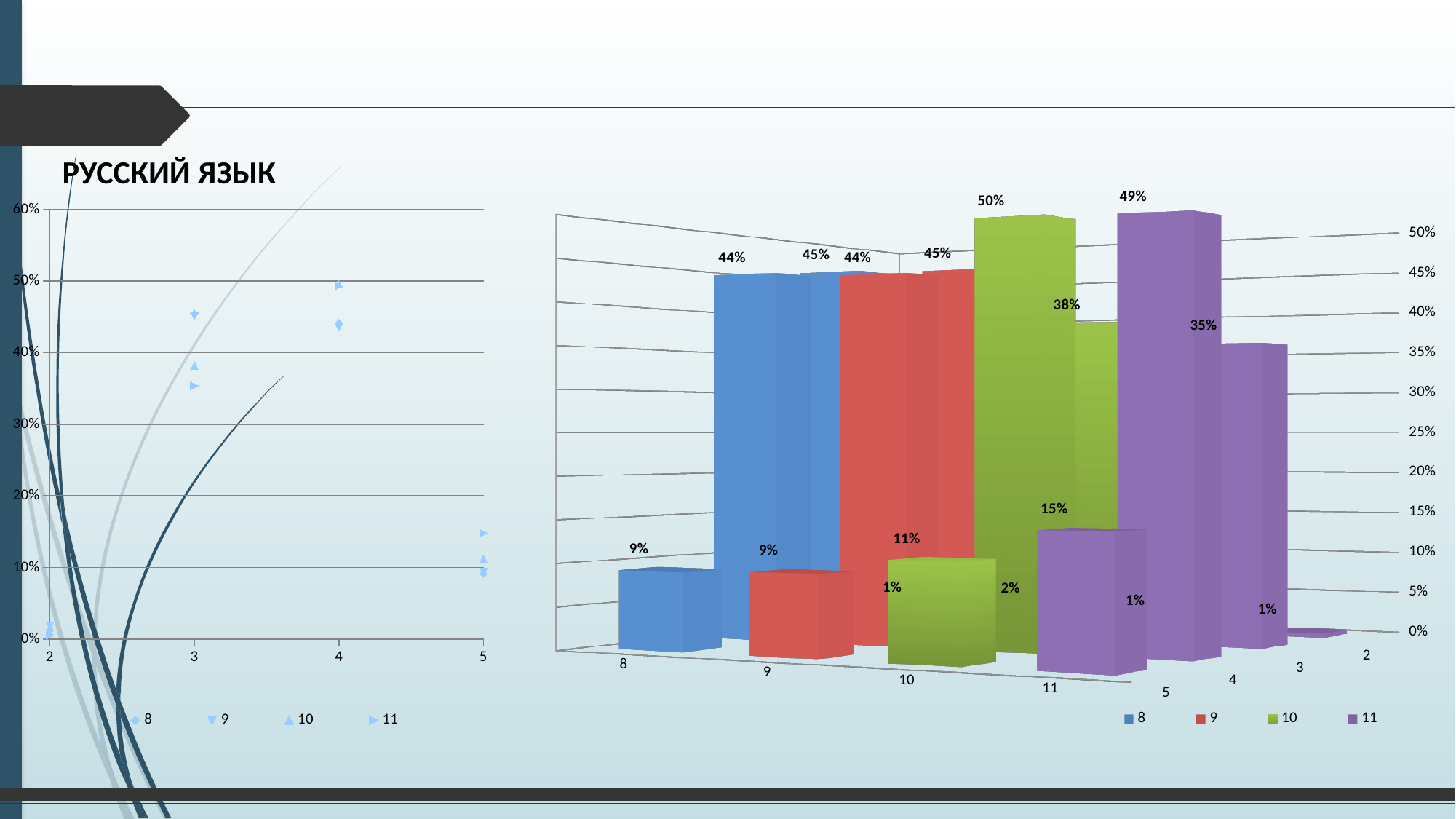
What is the title of the slide's charts? РУССКИЙ ЯЗЫК In the right-hand bar chart, what is the value for series 8 at category 4? 44% In the right-hand bar chart, which is larger at category 3: series 10 or series 11? series 10 In the right-hand bar chart, what is the highest value for series 10? 50% In the right-hand bar chart, what is the value for series 11 at category 5? 15% What kind of chart is the chart on the right of the slide? bar chart In the right-hand bar chart, how many series does the legend list? 4 In the right-hand bar chart, what is the value for series 10 at category 5? 11% In the right-hand bar chart, what is the highest value for series 11? 49% In the right-hand bar chart, what is the difference between series 11 and series 10 at category 5? 4% In the left-hand scatter chart, how many series does the legend list? 4 What kind of chart is the chart on the left of the slide? scatter chart